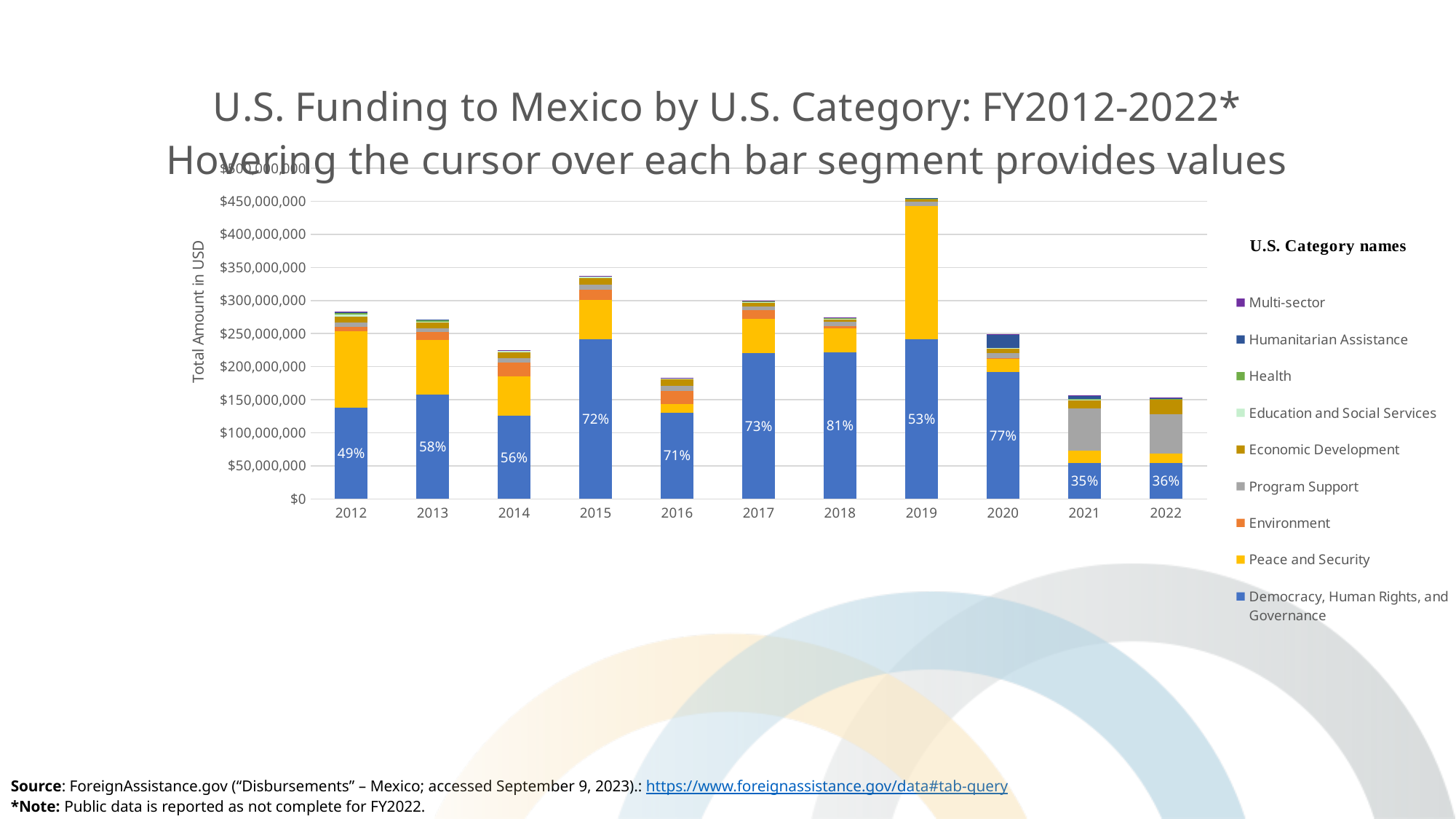
What percentage label is shown on the Democracy, Human Rights, and Governance segment for 2018? 81% Is the total funding for 2016 greater or less than $200,000,000? less Which category is shown in yellow in the legend? Peace and Security Which year has the highest total funding bar? 2019 What is the difference in percentage points between the Democracy, Human Rights, and Governance labels for 2018 and 2012? 32 percentage points What type of chart is shown on the slide? Stacked bar chart How many fiscal years are plotted on the x axis? 11 Which year has a larger total funding bar, 2015 or 2016? 2015 What percentage label is shown on the Democracy, Human Rights, and Governance segment for 2012? 49% Which year has the lowest percentage label on the Democracy, Human Rights, and Governance segment? 2021 Is the total funding for 2019 greater or less than $400,000,000? greater How many U.S. categories does the legend list? 9